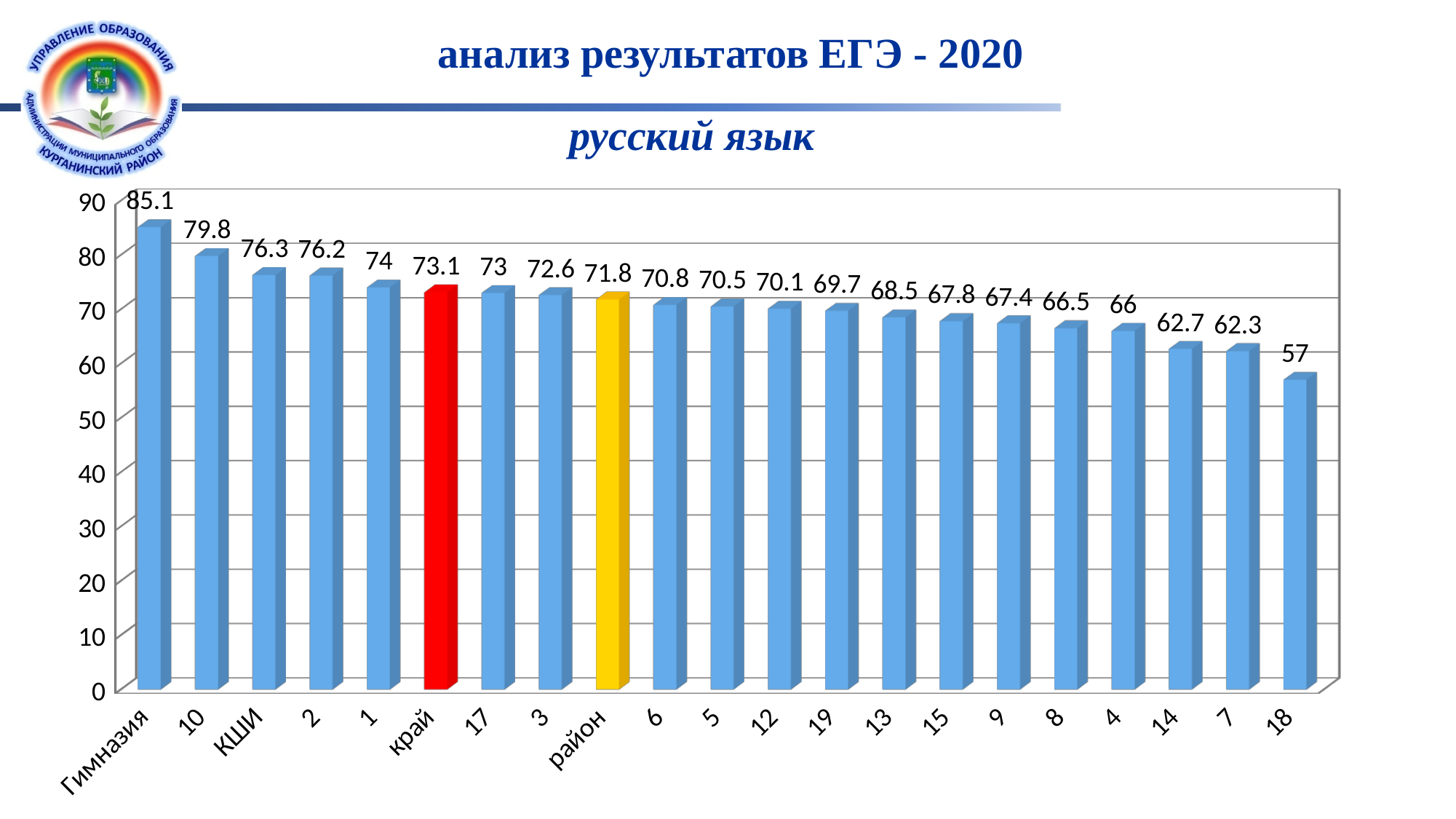
How many categories are shown on the x axis? 21 Which category has the highest value? Гимназия What is the value for Гимназия? 85.1 What is the value for район? 71.8 What is the difference between the values for край and район? 1.3 What colour is the bar for край? red What is the value for school 18? 57 What is the difference between the values for Гимназия and 18? 28.1 What is the value for край? 73.1 Which category has the lowest value? 18 Which is larger, the value for 10 or the value for КШИ? 10 What kind of chart is shown on the slide? bar chart